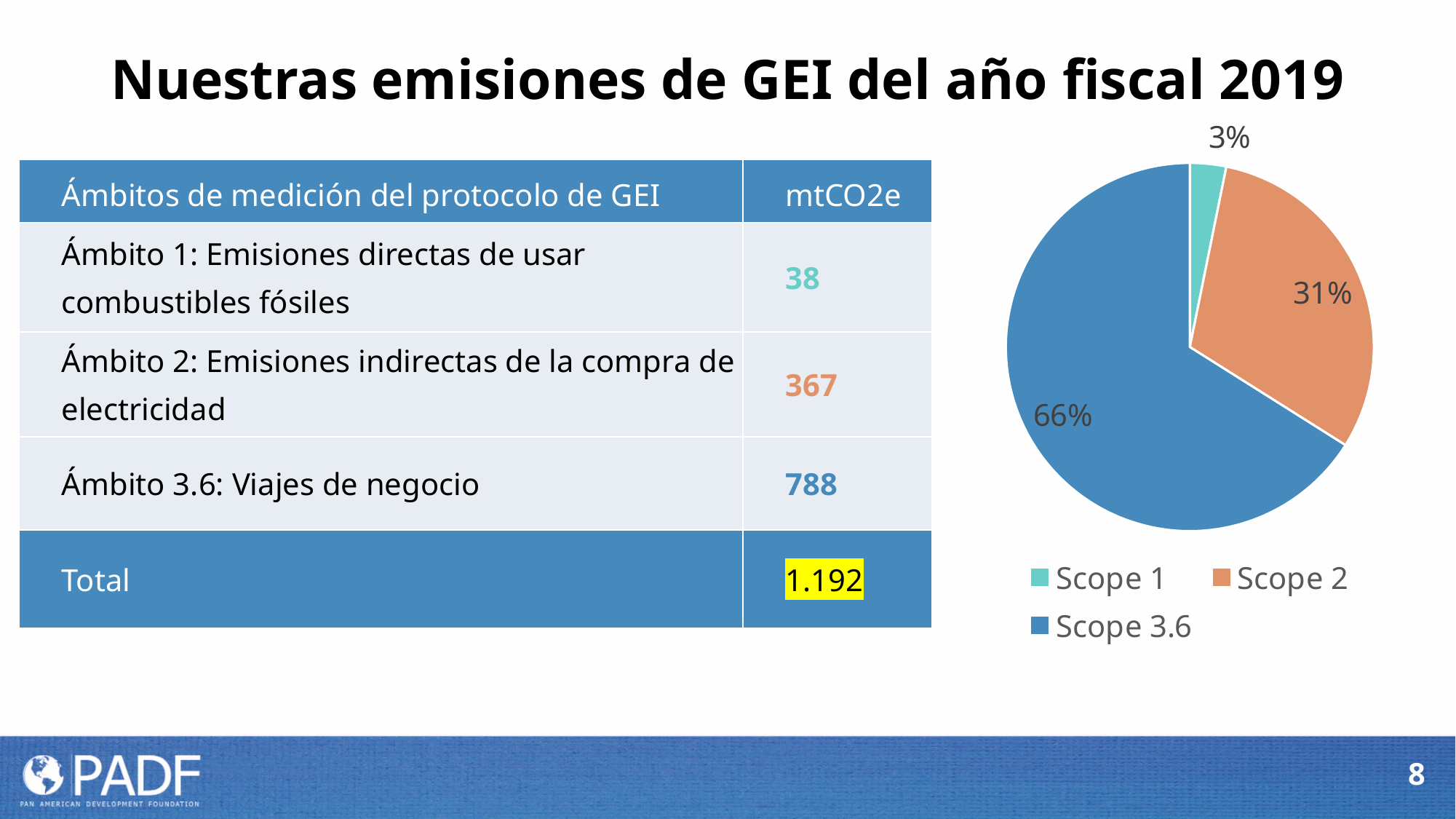
How many slices does the pie chart have? 3 Which scope has the largest slice of the pie? Scope 3.6 How many entries does the legend list? 3 What share of the pie does Scope 2 represent? 31% What kind of chart is shown on the slide? pie chart What share of the pie does Scope 3.6 represent? 66% What is the difference in percentage points between the Scope 3.6 slice and the Scope 2 slice? 35 Which is larger, the Scope 2 slice or the Scope 1 slice? Scope 2 What share of the pie does Scope 1 represent? 3% What colour is the Scope 1 slice in the pie chart? teal Which scope has the smallest slice of the pie? Scope 1 What colour is the Scope 2 slice in the pie chart? orange